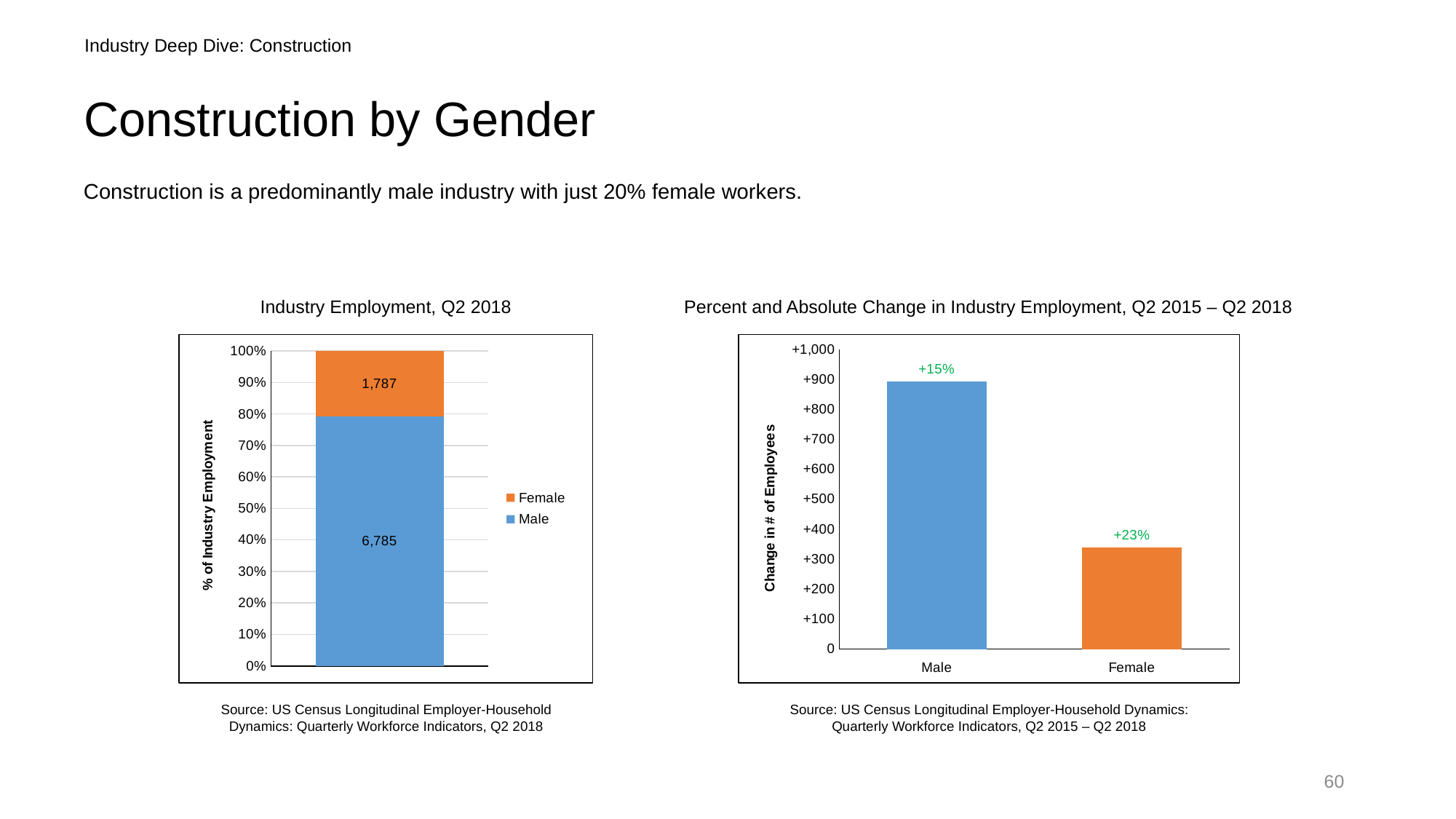
In the Industry Employment, Q2 2018 chart, what is the value shown for Male? 6,785 What kind of chart is the Industry Employment, Q2 2018 chart? Stacked bar chart In the Industry Employment, Q2 2018 chart, what is the value shown for Female? 1,787 In the Industry Employment, Q2 2018 chart, what is the total of the Male and Female values in the stacked bar? 8,572 In the Percent and Absolute Change in Industry Employment chart, is the change in number of employees for Female greater or less than +400? less In the Industry Employment, Q2 2018 chart, what is the difference between the Male and Female values? 4,998 In the Percent and Absolute Change in Industry Employment chart, is the change in number of employees for Male greater or less than +800? greater In the Percent and Absolute Change in Industry Employment chart, which category has the highest change in number of employees? Male In the Industry Employment, Q2 2018 chart, which is larger, the Male value or the Female value? Male How many series does the legend of the Industry Employment, Q2 2018 chart list? 2 In the Percent and Absolute Change in Industry Employment chart, what percent change is labelled for Female? +23% In the Percent and Absolute Change in Industry Employment chart, what percent change is labelled for Male? +15%